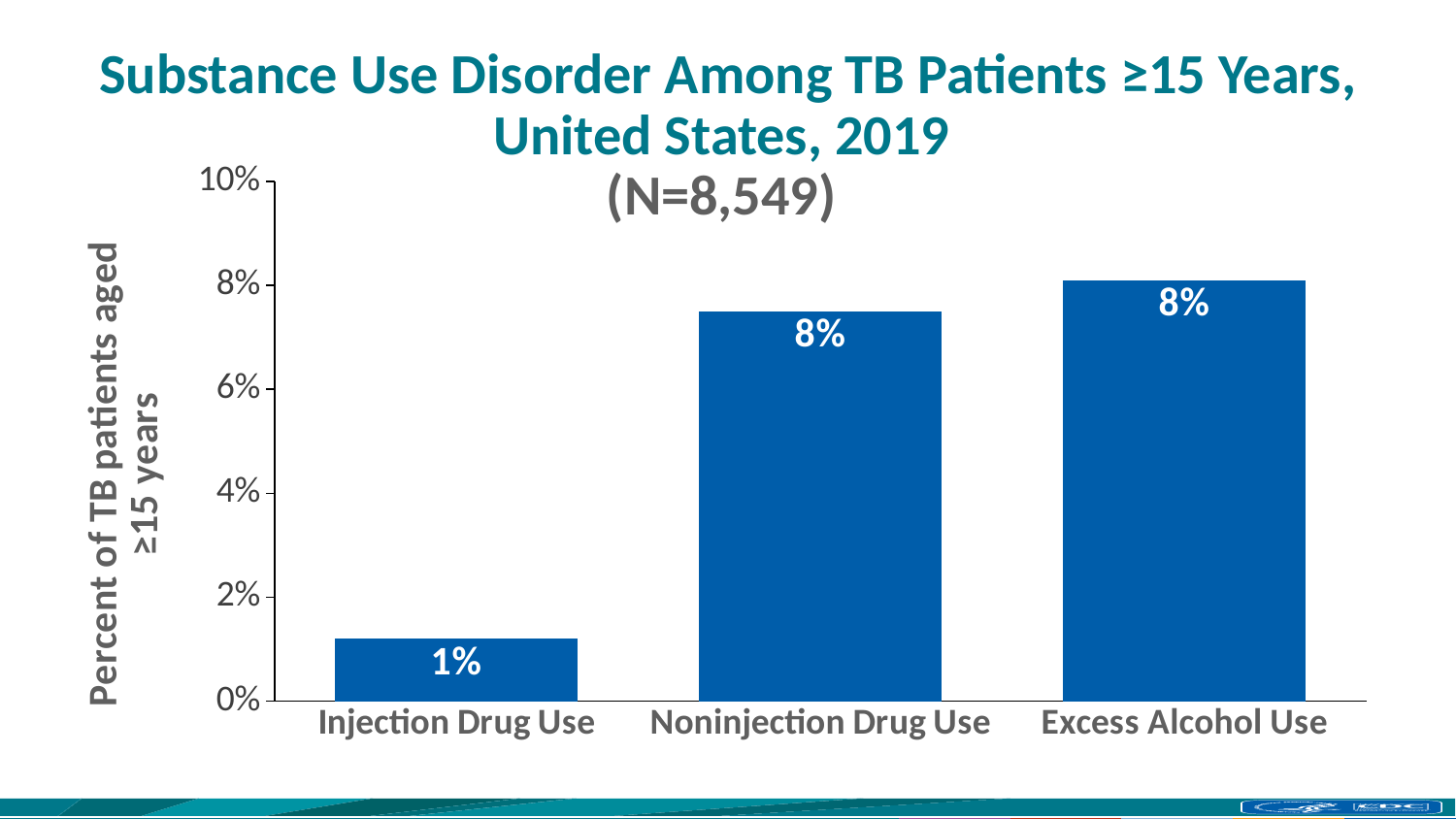
Which is larger, the value for Injection Drug Use or the value for Noninjection Drug Use? Noninjection Drug Use What is the value for Excess Alcohol Use? 8% What kind of chart is shown on the slide? bar chart What is the label of the y axis? Percent of TB patients aged ≥15 years What is the difference between the value for Excess Alcohol Use and the value for Injection Drug Use? 7% What is the sample size (N) given in the chart title? 8,549 What is the value for Injection Drug Use? 1% Which category has the lowest value? Injection Drug Use What is the value for Noninjection Drug Use? 8% How many categories are shown on the x axis? 3 Is the value for Noninjection Drug Use greater or less than 6%? greater Is the value for Injection Drug Use greater or less than 2%? less